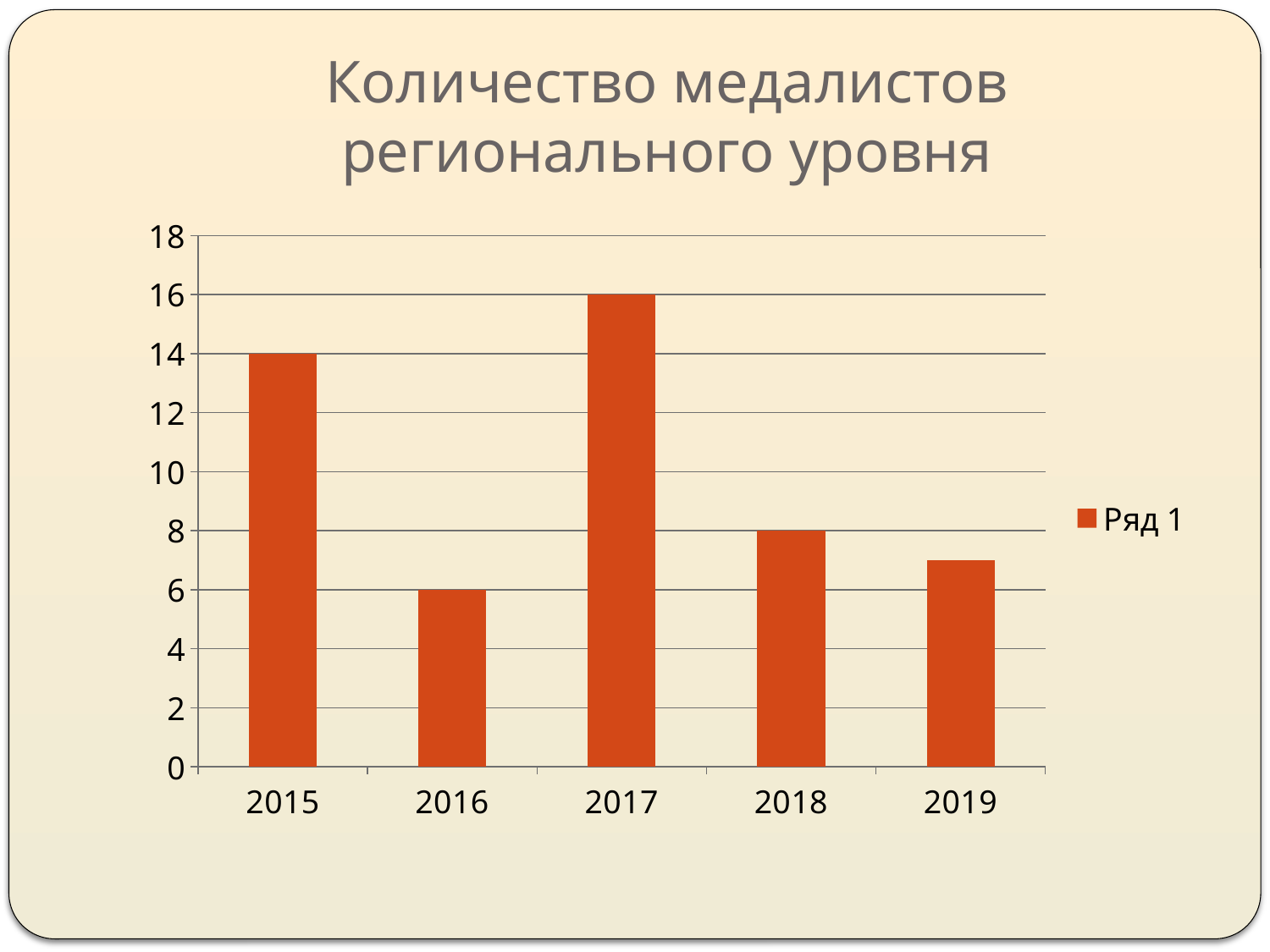
What is the value for 2015? 14 What is the title of the chart? Количество медалистов регионального уровня Is the value for 2019 greater or less than 6? greater How many series does the legend list? 1 What is the value for 2016? 6 What is the value for 2017? 16 What is the value for 2018? 8 How many years are shown on the x axis? 5 What type of chart is shown on the slide? bar chart Which year has the lowest value? 2016 Which year has the highest value? 2017 What is the difference between the values for 2017 and 2015? 2